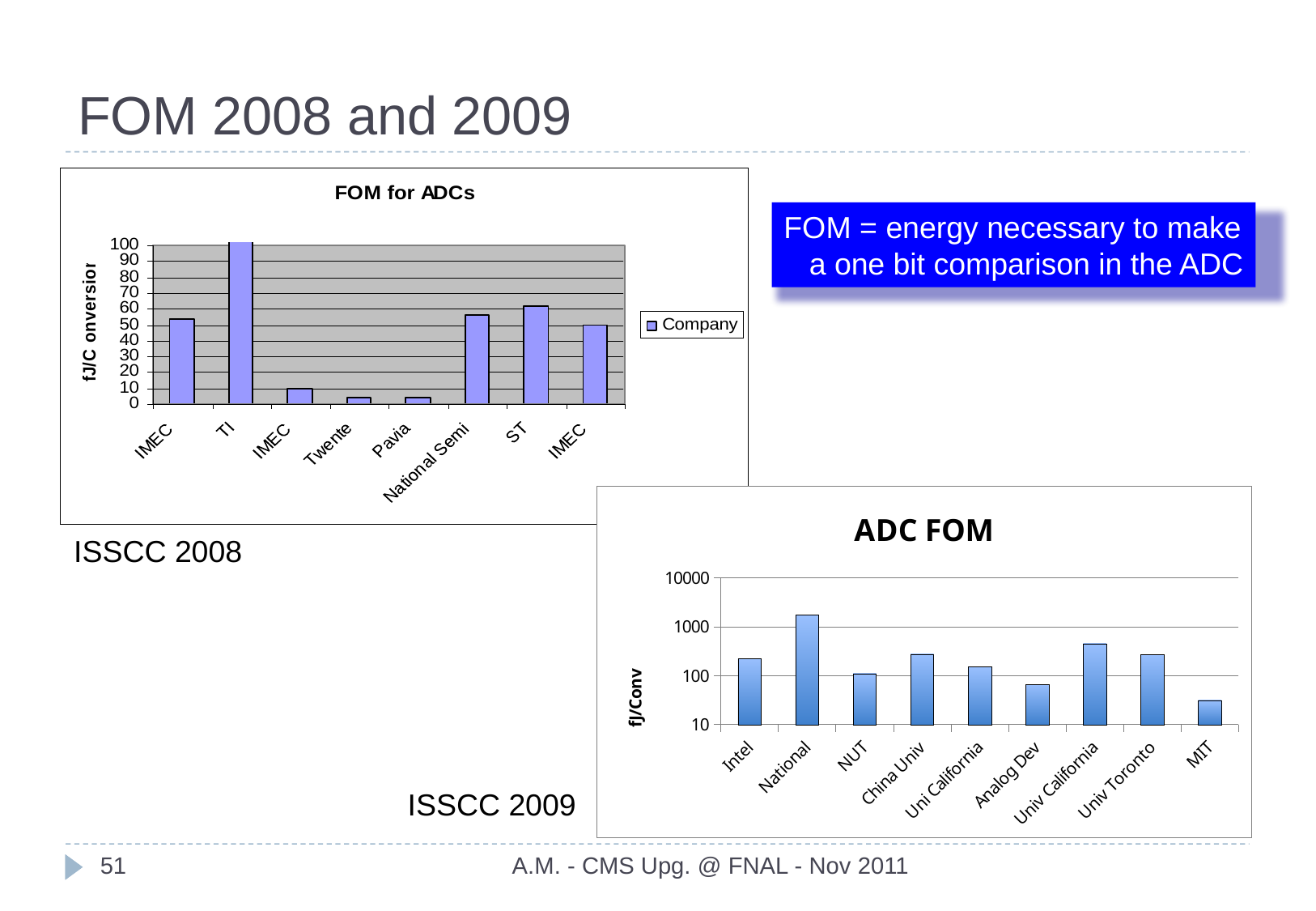
In the 'FOM for ADCs' chart, what entry does the legend list? Company In the 'ADC FOM' chart, which category has the lowest value? MIT In the 'ADC FOM' chart, which category has the highest value? National In the 'ADC FOM' chart, is the value for National greater or less than 1000? greater In the 'FOM for ADCs' chart, which is larger, the value for TI or the value for ST? TI In the 'FOM for ADCs' chart, how many bars are plotted? 8 In the 'FOM for ADCs' chart, is the value for Twente greater or less than 10? less What kind of chart is the 'ADC FOM' chart? bar chart In the 'ADC FOM' chart, how many categories are shown on the x axis? 9 In the 'FOM for ADCs' chart, which category has the highest value? TI In the 'ADC FOM' chart, is the value for Analog Dev greater or less than 100? less